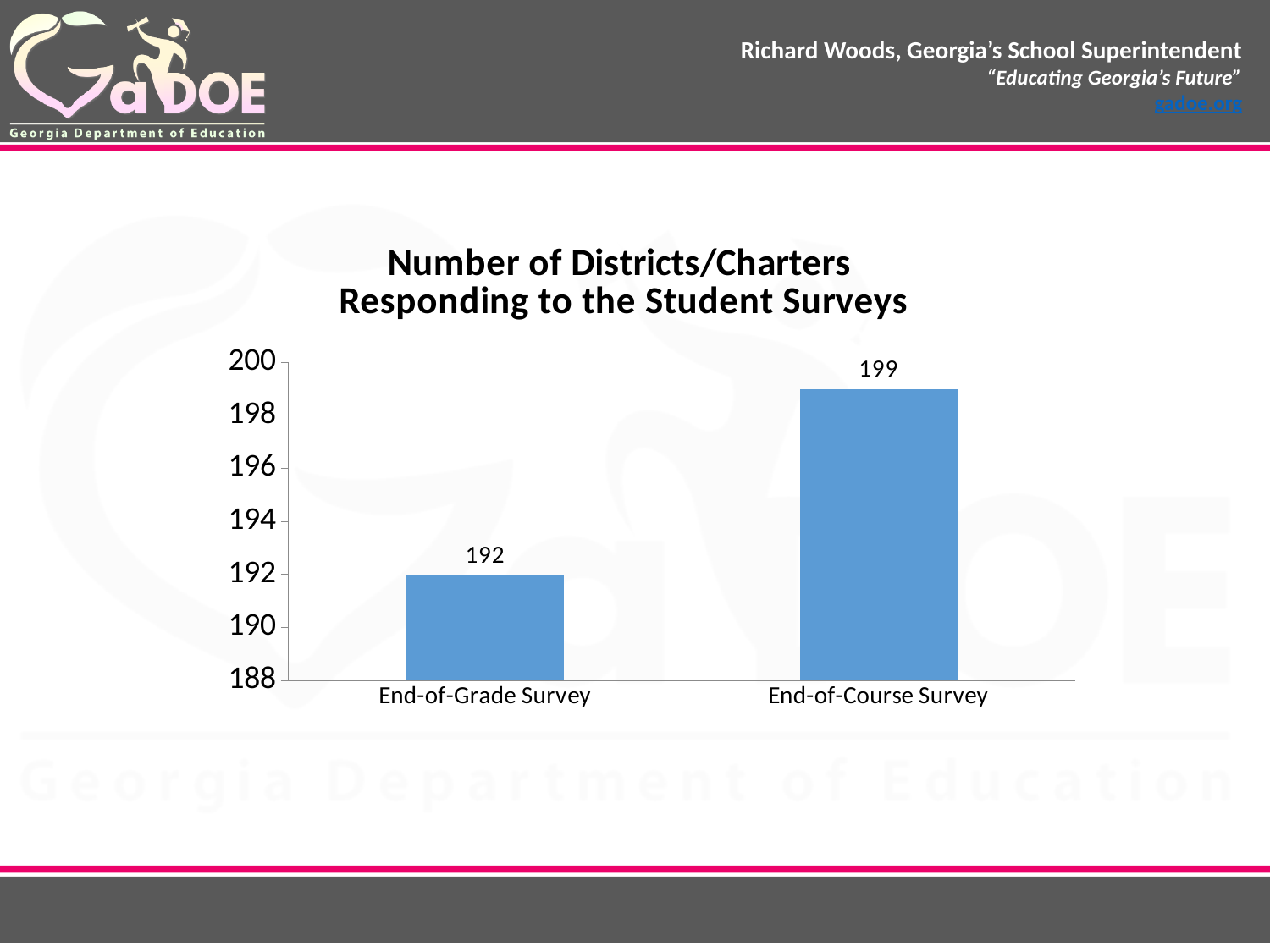
Is the value for the End-of-Grade Survey greater or less than 194? less Which had more districts/charters responding: the End-of-Grade Survey or the End-of-Course Survey? End-of-Course Survey What is the number of districts/charters responding to the End-of-Grade Survey? 192 What is the title of the chart? Number of Districts/Charters Responding to the Student Surveys What is the difference between the number of districts/charters responding to the End-of-Course Survey and the End-of-Grade Survey? 7 How many categories are shown on the chart? 2 Which survey had the lowest number of districts/charters responding? End-of-Grade Survey Is the value for the End-of-Course Survey greater or less than 196? greater What kind of chart is shown on the slide? Bar chart What is the number of districts/charters responding to the End-of-Course Survey? 199 What is the maximum value shown on the vertical axis of the chart? 200 Which survey had the highest number of districts/charters responding? End-of-Course Survey